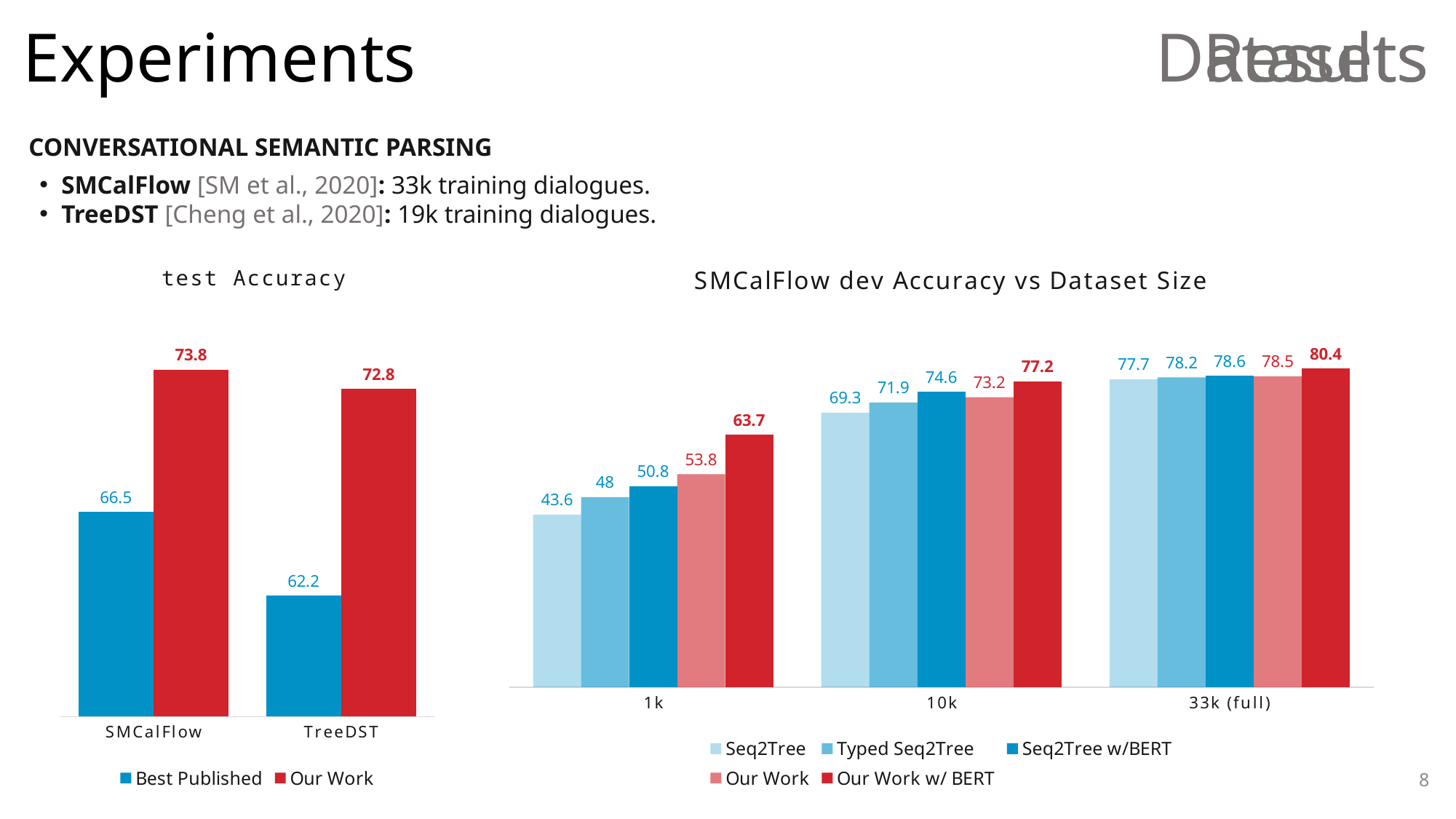
In the 'SMCalFlow dev Accuracy vs Dataset Size' chart, how many series does the legend list? 5 In the 'test Accuracy' chart, what is the value for Best Published on TreeDST? 62.2 In the 'SMCalFlow dev Accuracy vs Dataset Size' chart, which series has the highest value at 33k (full)? Our Work w/ BERT In the 'SMCalFlow dev Accuracy vs Dataset Size' chart, what is the value for Our Work w/ BERT at 10k? 77.2 In the 'test Accuracy' chart, what is the value for Our Work on SMCalFlow? 73.8 In the 'test Accuracy' chart, which dataset has the lower Best Published value? TreeDST In the 'test Accuracy' chart, how many series does the legend list? 2 In the 'SMCalFlow dev Accuracy vs Dataset Size' chart, what is the value for Seq2Tree at 1k? 43.6 In the 'test Accuracy' chart, what is the difference between Our Work and Best Published on SMCalFlow? 7.3 In the 'SMCalFlow dev Accuracy vs Dataset Size' chart, how many dataset size categories are shown on the x axis? 3 What kind of chart is the 'SMCalFlow dev Accuracy vs Dataset Size' chart? bar chart In the 'SMCalFlow dev Accuracy vs Dataset Size' chart, does the Our Work w/ BERT value rise or fall as dataset size increases? rise